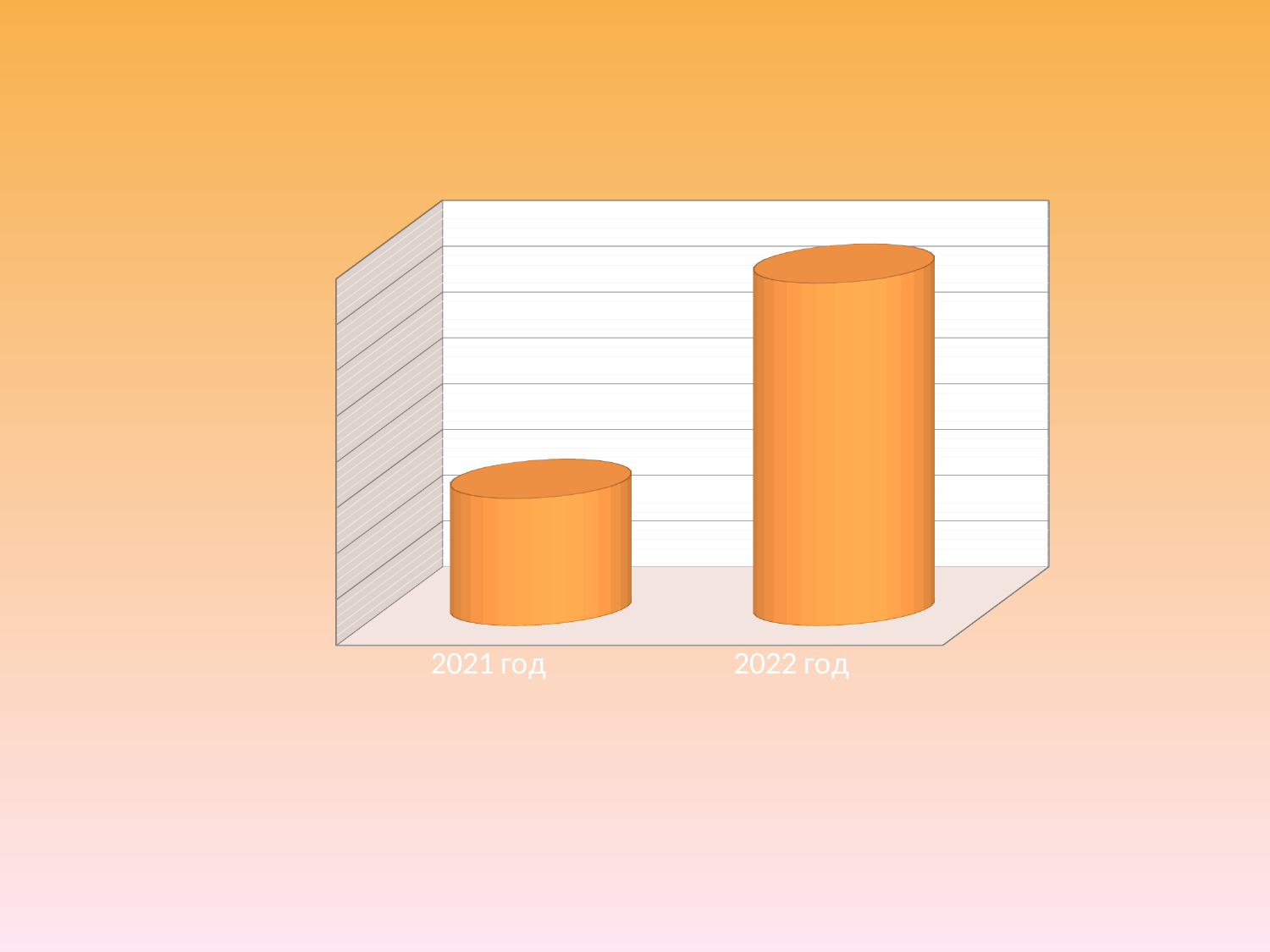
How many categories are shown on the x axis of the chart? 2 What are the two category labels on the x axis of the chart? 2021 год and 2022 год What kind of chart is shown on the slide? bar chart What colour are the bars in the chart? orange Which category has the lowest bar in the chart? 2021 год Which category has the highest bar in the chart? 2022 год Which is larger, the bar for 2021 год or the bar for 2022 год? 2022 год Do the values rise or fall from 2021 год to 2022 год? rise